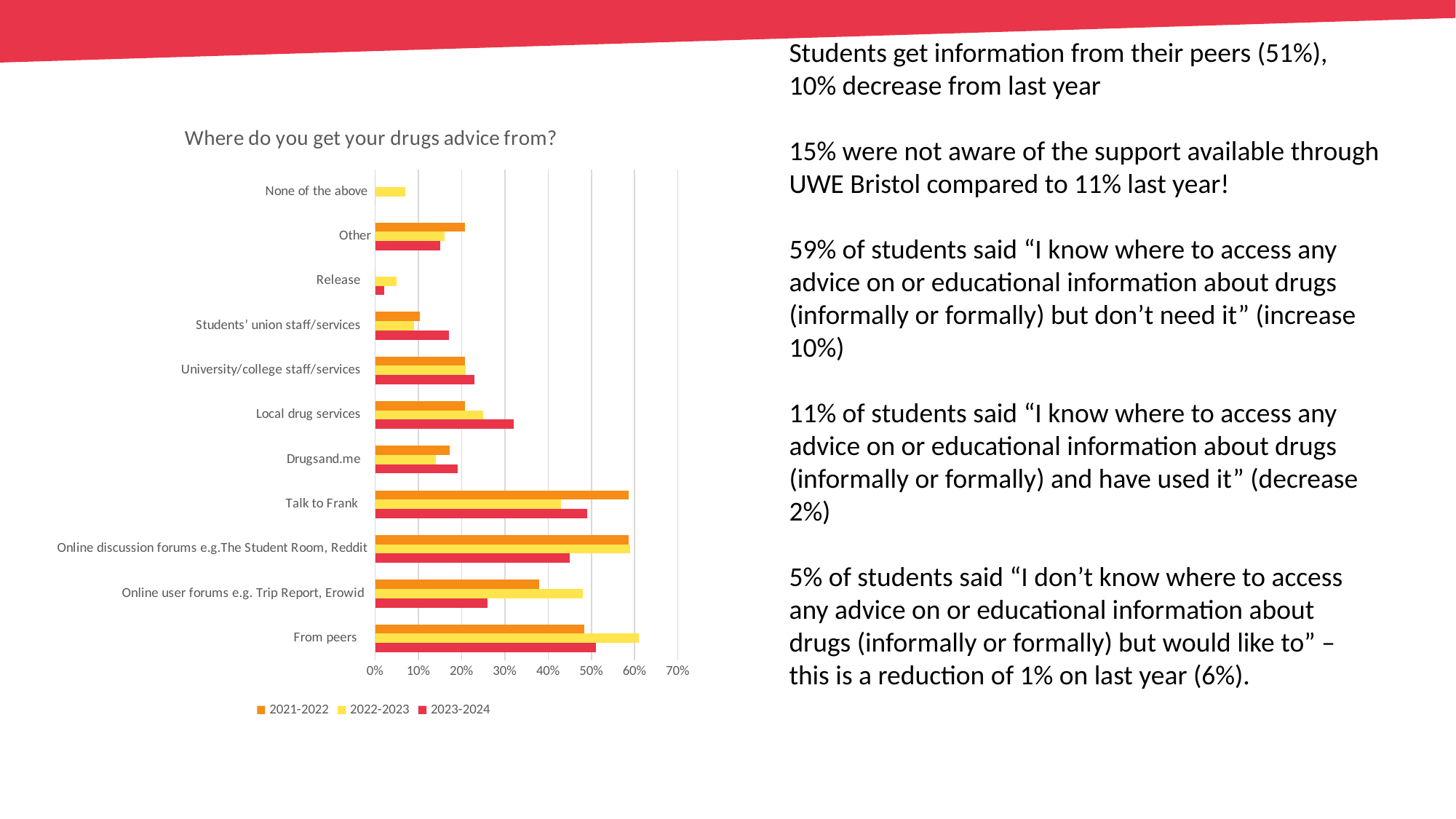
For Local drug services, which is larger: the 2021-2022 value or the 2023-2024 value? 2023-2024 Is the 2023-2024 value for Online user forums e.g. Trip Report, Erowid greater or less than 30%? less Is the 2021-2022 value for Talk to Frank greater or less than 50%? greater Is the 2022-2023 value for From peers greater or less than 50%? greater How many categories are shown on the chart's vertical axis? 11 What type of chart is shown on the slide? Bar chart For Online user forums e.g. Trip Report, Erowid, which is larger: the 2022-2023 value or the 2023-2024 value? 2022-2023 For Talk to Frank, which is larger: the 2021-2022 value or the 2022-2023 value? 2021-2022 What is the title of the chart? Where do you get your drugs advice from? How many series does the chart legend list? 3 Which series is shown in red in the chart legend? 2023-2024